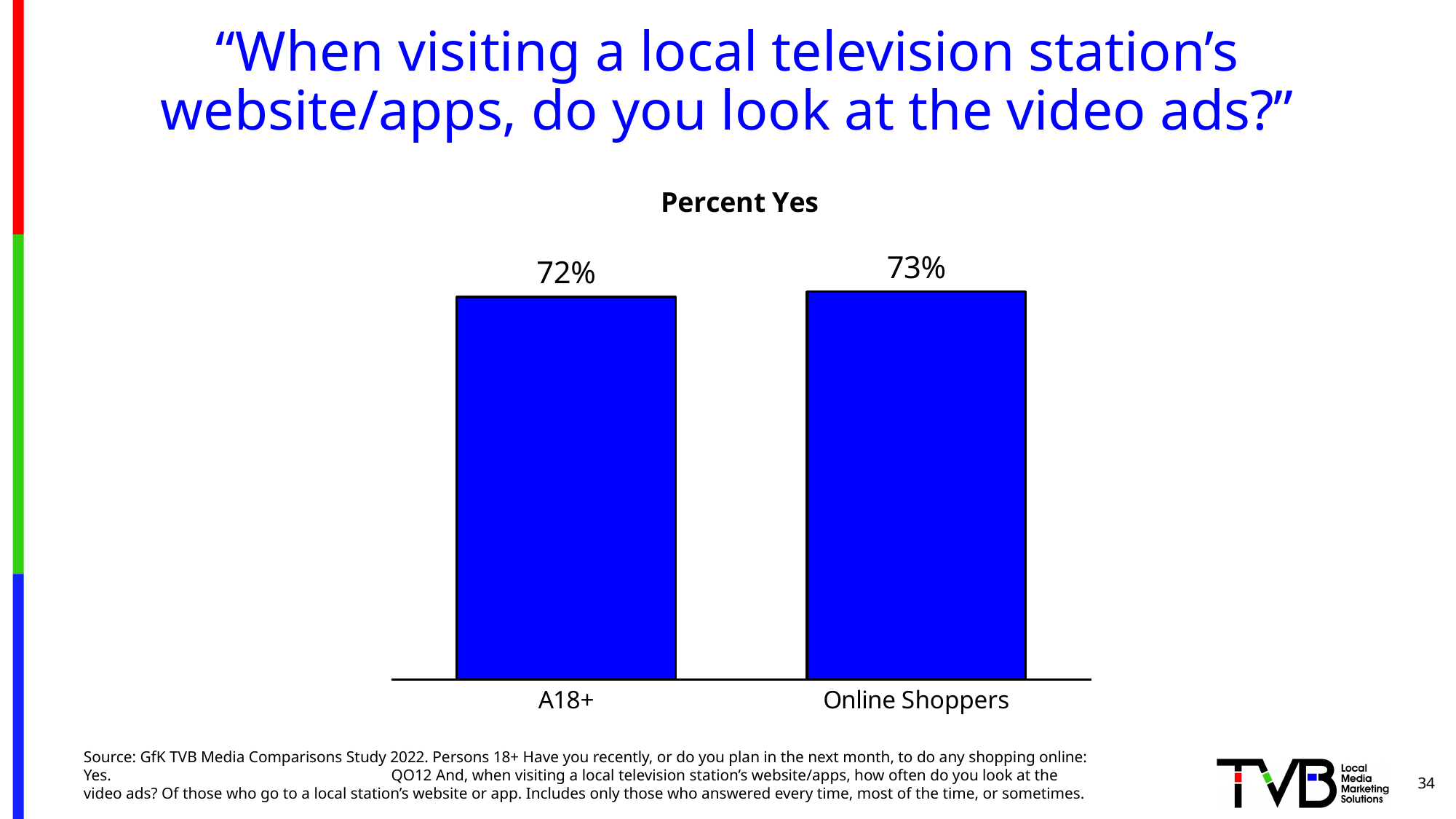
How many categories are shown in the chart? 2 Which category has the higher Percent Yes value? Online Shoppers What is the difference between the Online Shoppers value and the A18+ value? 1% What is the Percent Yes value for Online Shoppers? 73% What kind of chart is shown on the slide? bar chart What colour are the bars in the chart? blue Is the value for Online Shoppers larger or smaller than the value for A18+? larger What is the title of the chart? Percent Yes Which category has the lower Percent Yes value? A18+ What is the Percent Yes value for A18+? 72%